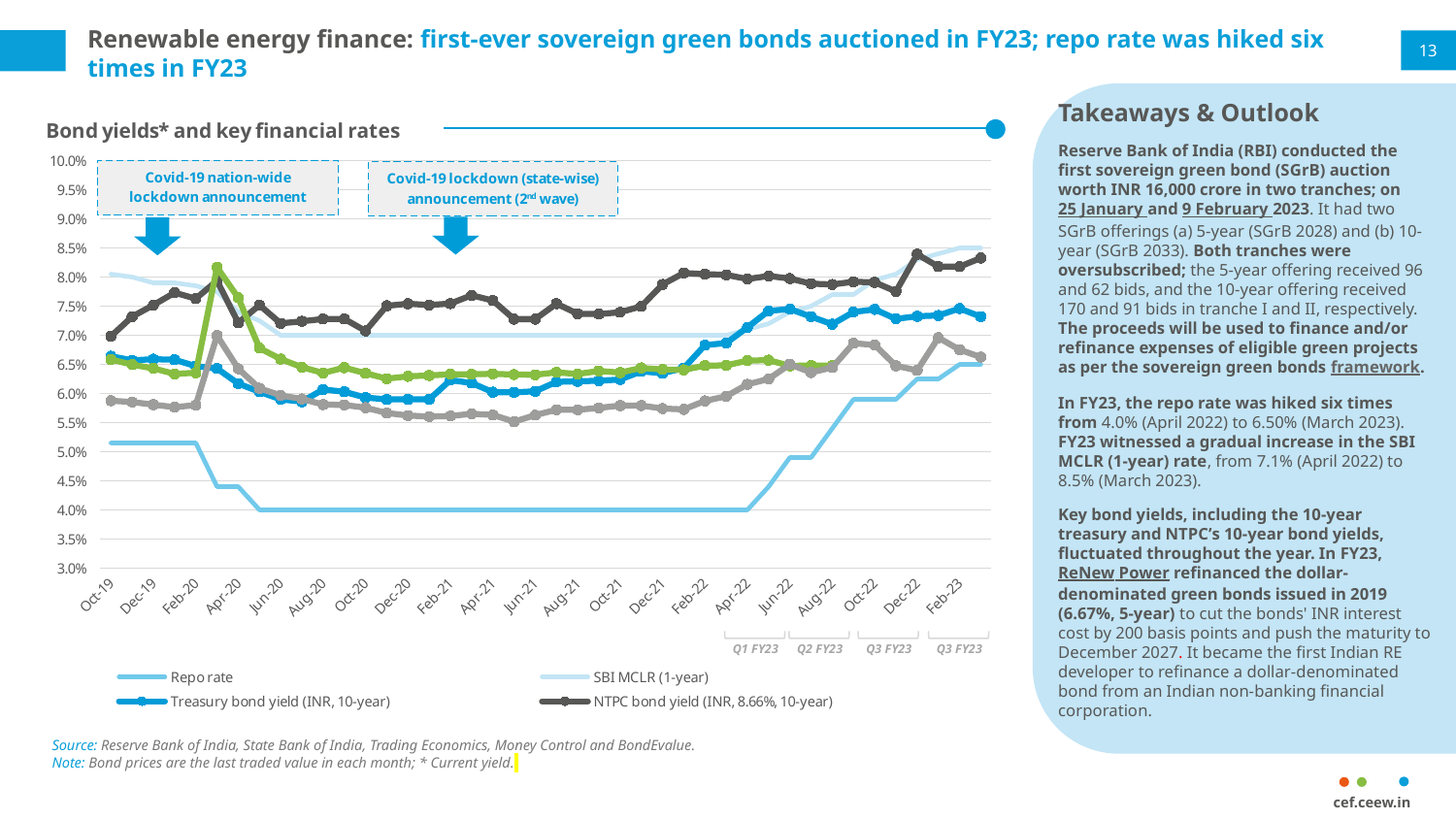
Is the NTPC bond yield (INR, 8.66%, 10-year) in Feb-23 greater or less than 8.0%? greater Is the Treasury bond yield (INR, 10-year) in Oct-19 greater or less than 7.0%? less How many series does the legend of the 'Bond yields* and key financial rates' chart list? 4 What is the highest value shown on the chart's y-axis? 10.0% Is the repo rate in Feb-23 greater or less than 6.0%? greater What is the repo rate shown for Jun-21 in the chart? 4.0% Does the repo rate rise or fall between Apr-22 and Feb-23? Rise Which series has the lowest value in Jun-21? Repo rate In Feb-23, which is higher: the NTPC bond yield or the Treasury bond yield? NTPC bond yield What is the title of the chart on the slide? Bond yields* and key financial rates What kind of chart is shown under the title 'Bond yields* and key financial rates'? Line chart